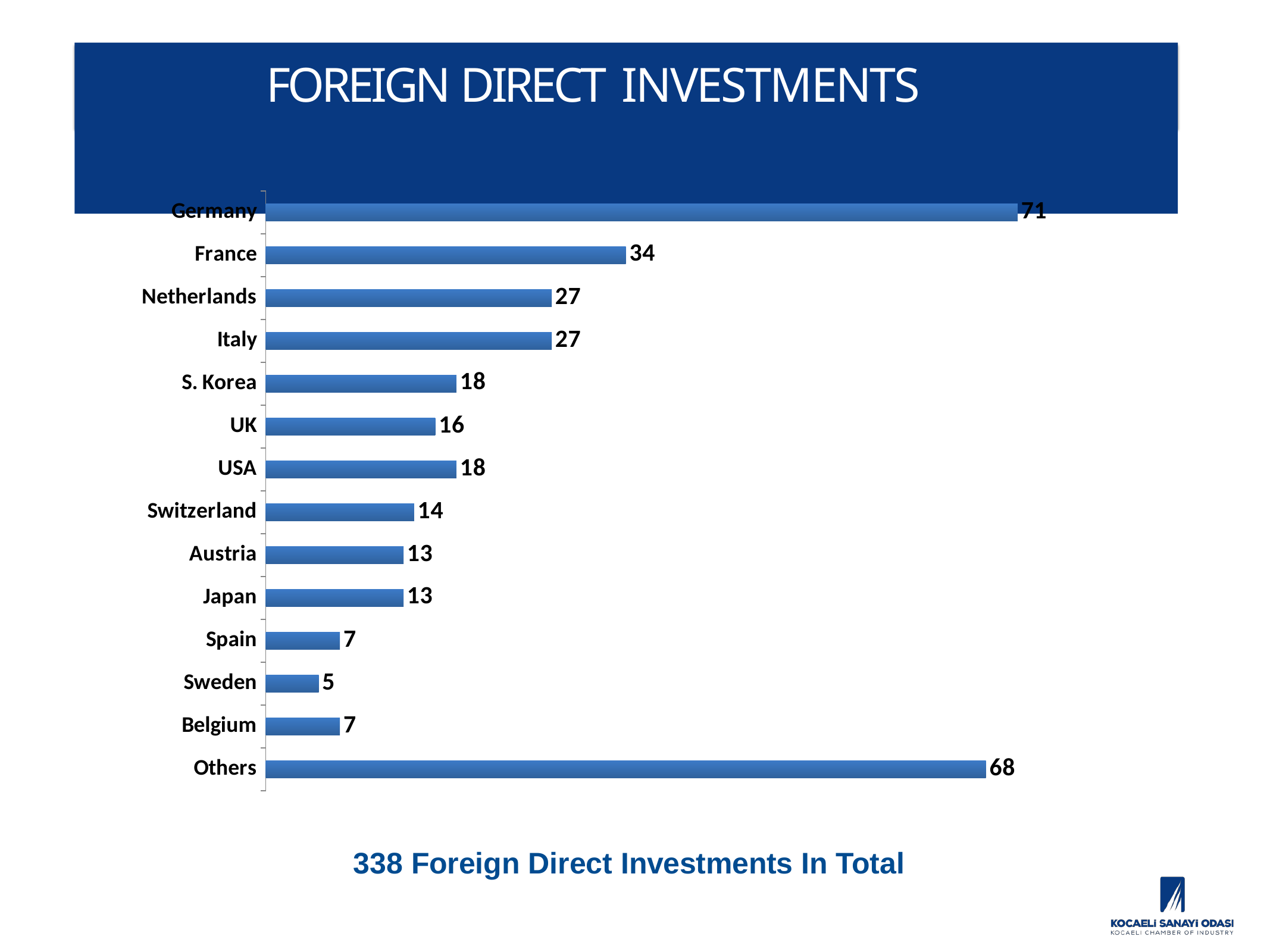
What is the difference between the values for S. Korea and UK? 2 What is the value for Others? 68 Which is larger, the value for Netherlands or the value for S. Korea? Netherlands Which category has the highest value? Germany What is the value for Germany? 71 What is the title of the slide? FOREIGN DIRECT INVESTMENTS What is the value for France? 34 What is the value for Switzerland? 14 What is the difference between the values for Germany and France? 37 Which category has the lowest value? Sweden What kind of chart is shown on the slide? Bar chart How many categories are shown in the chart? 14